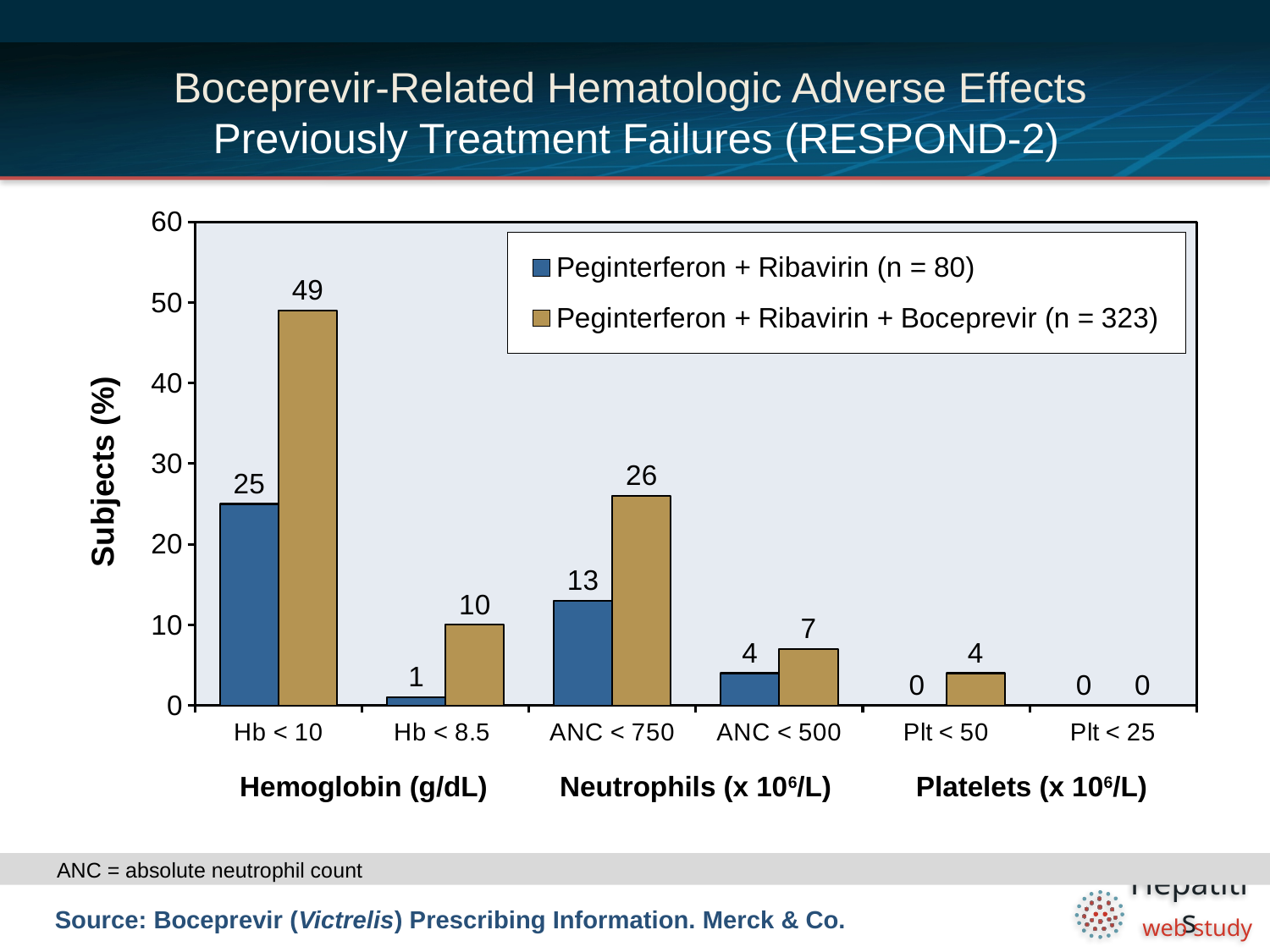
Which group has the larger value for Hb < 8.5? Peginterferon + Ribavirin + Boceprevir What is the difference between the two groups for Hb < 10? 24 What is the value for Plt < 50 in the Peginterferon + Ribavirin + Boceprevir group? 4 How many series does the legend list? 2 What percentage of subjects in the Peginterferon + Ribavirin + Boceprevir group had Hb < 10? 49 Which category has the highest value for the Peginterferon + Ribavirin + Boceprevir group? Hb < 10 What is the difference between the two groups for ANC < 750? 13 What is the sample size (n) for the Peginterferon + Ribavirin + Boceprevir group shown in the legend? 323 How many categories are shown on the x axis? 6 What is the label of the y axis? Subjects (%) What kind of chart is shown on the slide? Bar chart What percentage of subjects in the Peginterferon + Ribavirin group had ANC < 750? 13